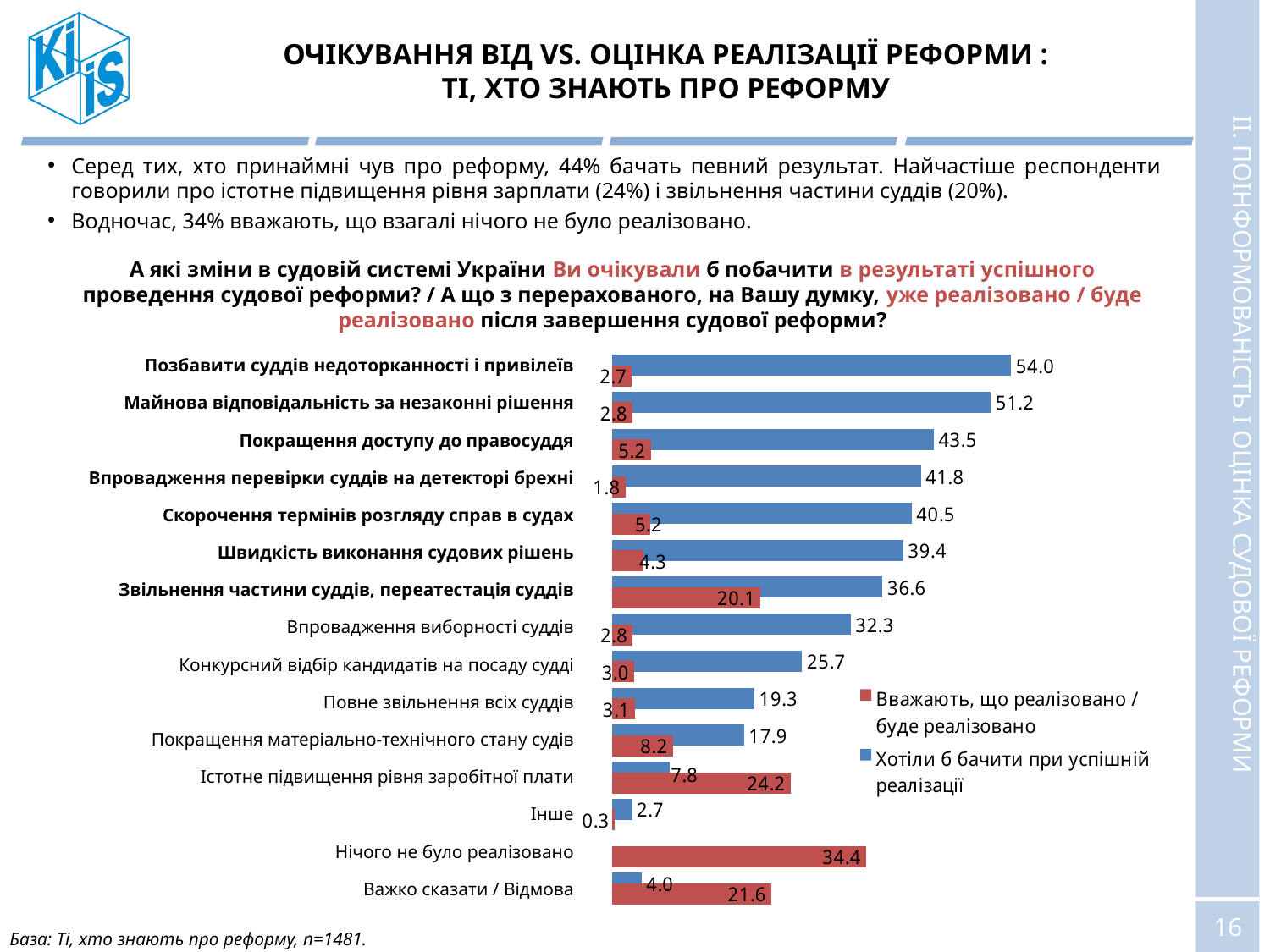
What is the value for "Впровадження перевірки суддів на детекторі брехні" in the series "Вважають, що реалізовано / буде реалізовано"? 1.8 Which category has the lowest value in the series "Вважають, що реалізовано / буде реалізовано"? Інше What is the value for "Істотне підвищення рівня заробітної плати" in the series "Вважають, що реалізовано / буде реалізовано"? 24.2 Which category has the highest value in the series "Хотіли б бачити при успішній реалізації"? Позбавити суддів недоторканності і привілеїв What is the value for "Нічого не було реалізовано" in the series "Вважають, що реалізовано / буде реалізовано"? 34.4 How many categories are shown on the chart? 15 How many series does the chart legend list? 2 For "Істотне підвищення рівня заробітної плати", which series has the larger value? Вважають, що реалізовано / буде реалізовано What is the value for "Позбавити суддів недоторканності і привілеїв" in the series "Хотіли б бачити при успішній реалізації"? 54.0 What is the difference between the two series for "Звільнення частини суддів, переатестація суддів"? 16.5 Which colour represents the series "Хотіли б бачити при успішній реалізації"? blue What kind of chart is shown on the slide? bar chart